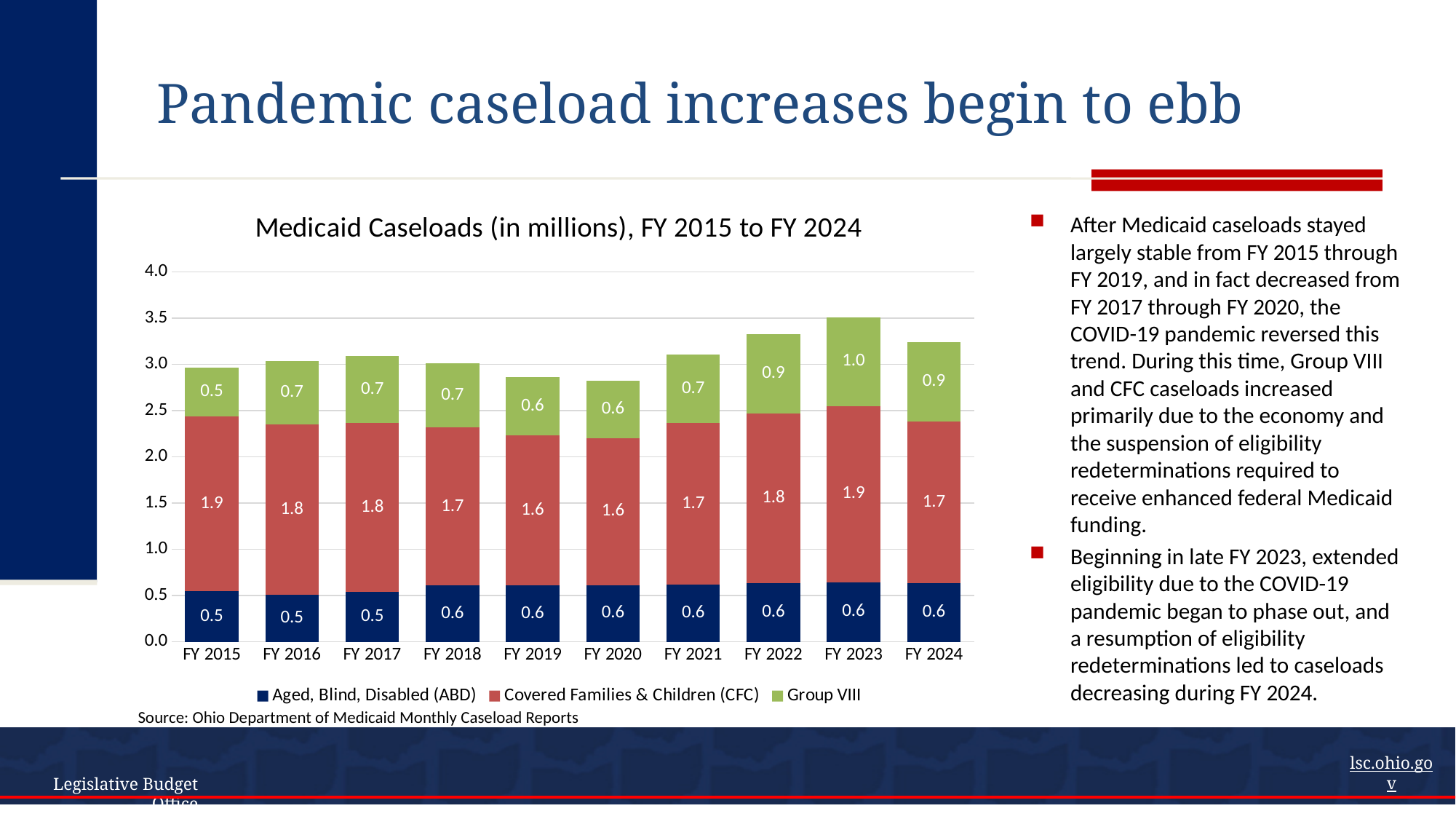
What is the Covered Families & Children (CFC) value for FY 2015? 1.9 How many fiscal years are shown on the x axis? 10 Is the total stacked bar for FY 2023 greater or less than 3.0? greater What is the total of the stacked bar for FY 2023, summing the three labelled segments? 3.5 What is the Aged, Blind, Disabled (ABD) value for FY 2016? 0.5 Which fiscal year has the tallest stacked bar overall? FY 2023 In which fiscal year is the Group VIII value highest? FY 2023 What is the difference between the Group VIII value in FY 2023 and in FY 2015? 0.5 How many series does the legend list? 3 Which is larger, the Group VIII value for FY 2022 or for FY 2019? FY 2022 What kind of chart is shown on the slide? Stacked bar chart What is the Group VIII value for FY 2023? 1.0